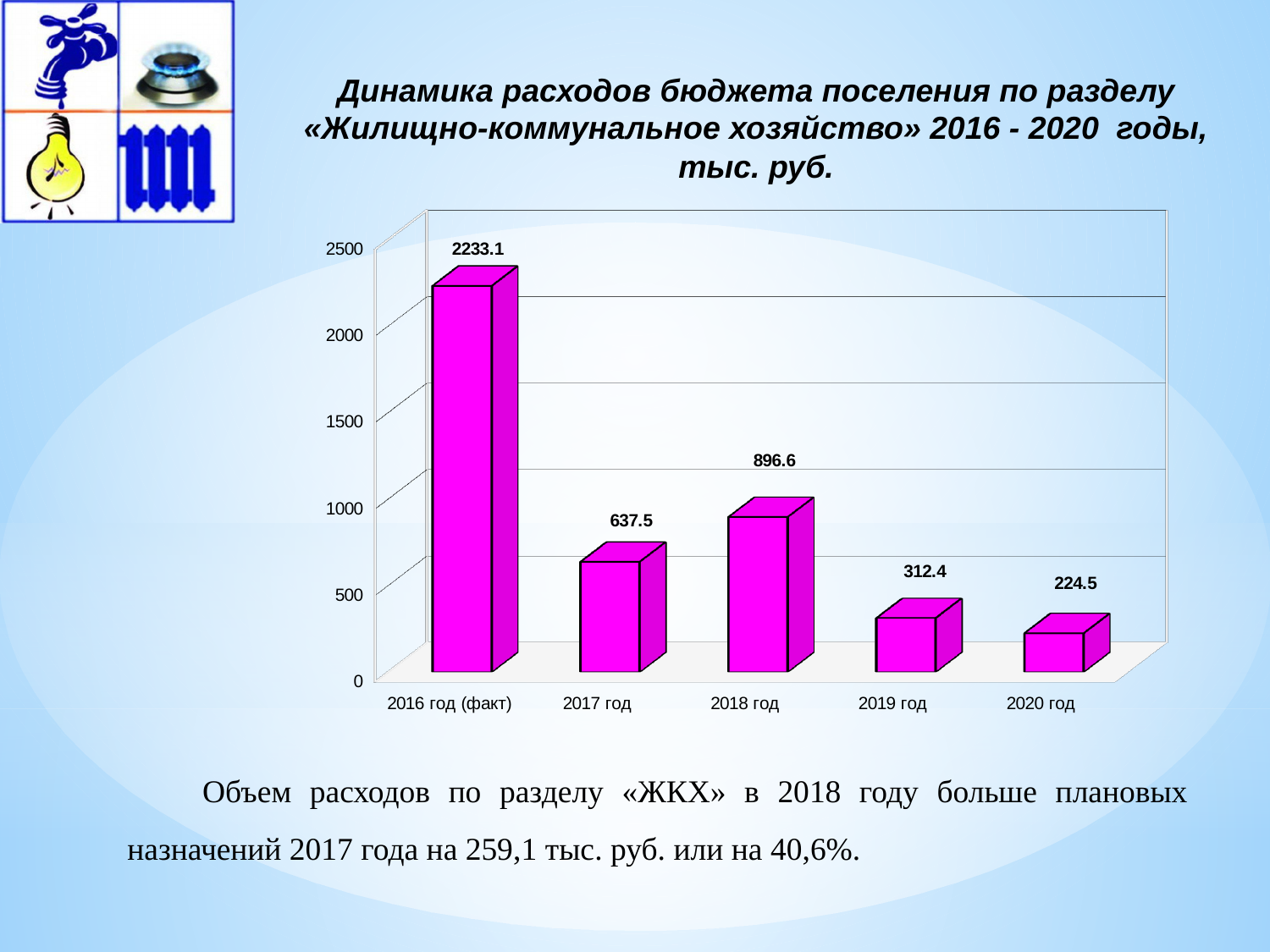
What is the value for 2018 год? 896.6 Which year has the lowest value? 2020 год Is the value for 2016 год (факт) greater or less than 2000? greater What is the difference between the values for 2019 год and 2020 год? 87.9 What kind of chart is shown on the slide? bar chart Which is larger, the value for 2017 год or the value for 2018 год? 2018 год Do the values generally rise or fall from 2018 год to 2020 год? fall Which year has the highest value? 2016 год (факт) What is the difference between the values for 2018 год and 2017 год? 259.1 How many years are shown on the x axis? 5 What is the value for 2020 год? 224.5 What is the value for 2016 год (факт)? 2233.1